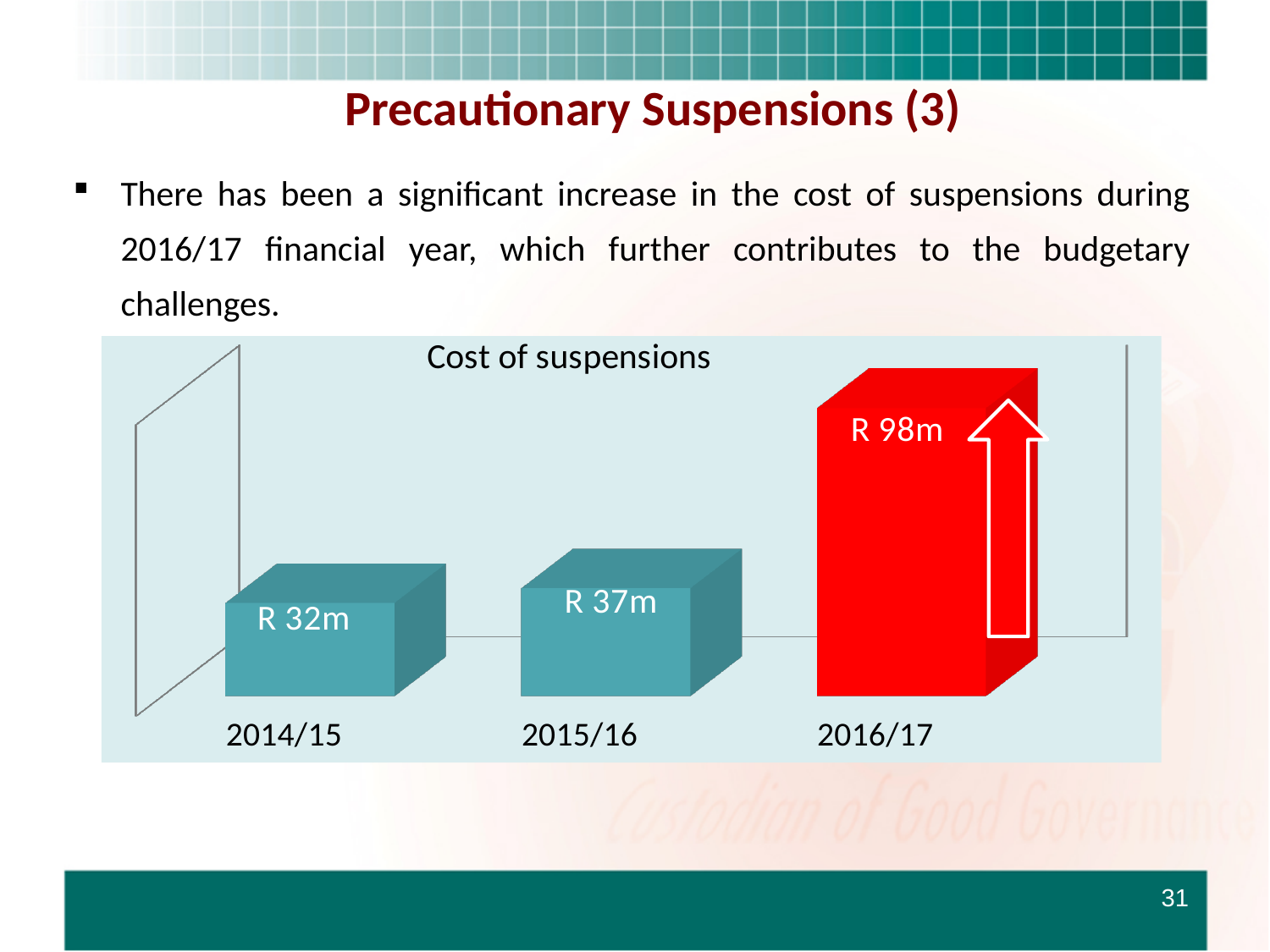
What is the cost of suspensions for 2015/16? R 37m What is the cost of suspensions for 2016/17? R 98m Does the cost of suspensions rise or fall from 2014/15 to 2016/17? Rise Which financial year has the lowest cost of suspensions? 2014/15 What is the title of the chart? Cost of suspensions What is the difference in cost of suspensions between 2016/17 and 2015/16? R 61m Which year has a higher cost of suspensions, 2014/15 or 2016/17? 2016/17 How many financial years are shown in the chart? 3 What is the cost of suspensions for 2014/15? R 32m Which financial year has the highest cost of suspensions? 2016/17 What kind of chart is used to show the cost of suspensions? Bar chart What is the difference in cost of suspensions between 2015/16 and 2014/15? R 5m